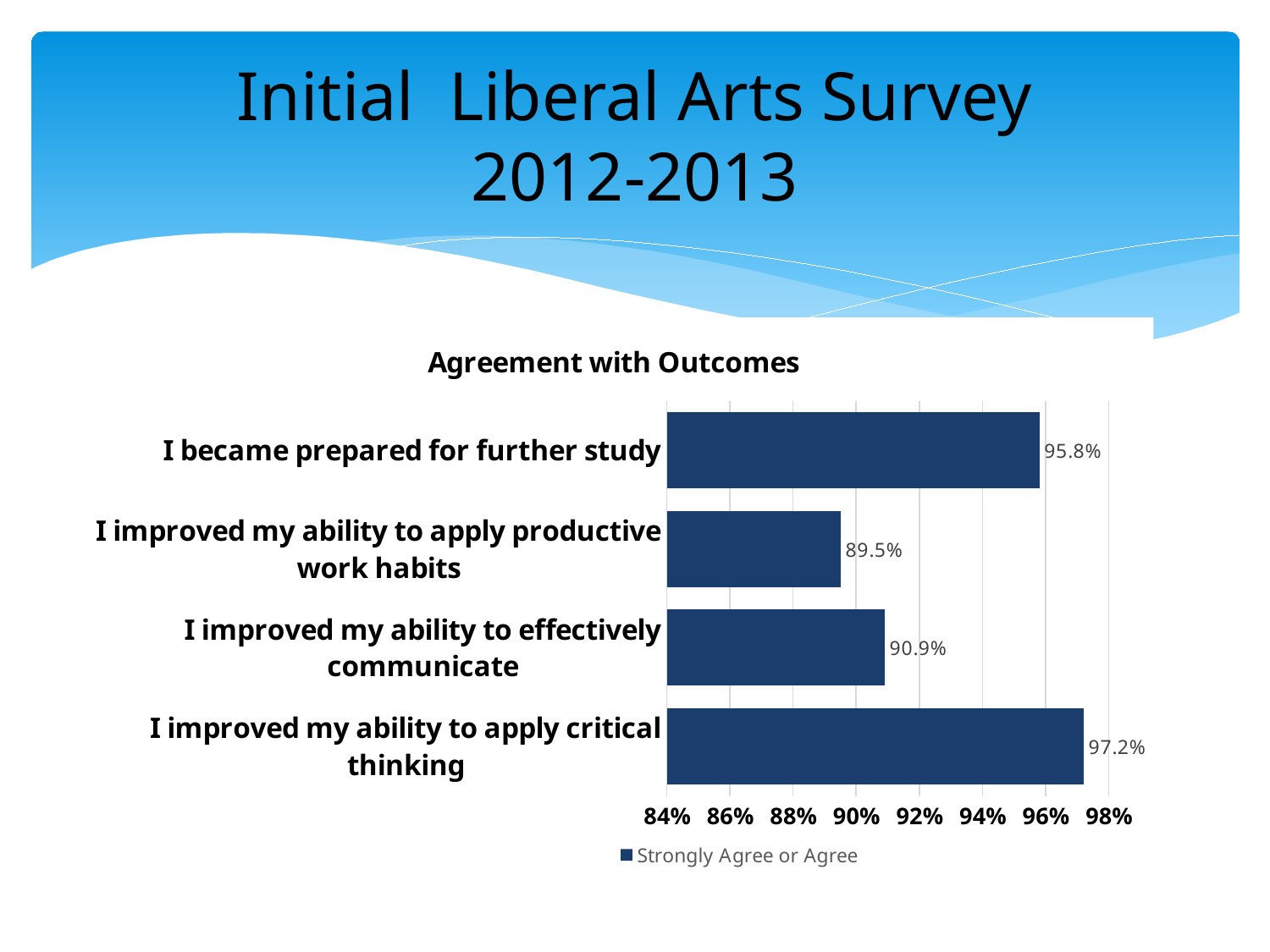
What is the title of the chart? Agreement with Outcomes How many outcome statements are shown in the chart? 4 Which outcome has the highest level of agreement? I improved my ability to apply critical thinking Is the value for "I improved my ability to effectively communicate" greater or less than 92%? less What is the value for "I improved my ability to apply critical thinking"? 97.2% What is the value for "I improved my ability to apply productive work habits"? 89.5% Which has a higher agreement value: "I became prepared for further study" or "I improved my ability to effectively communicate"? I became prepared for further study What percentage of respondents strongly agreed or agreed with "I became prepared for further study"? 95.8% What type of chart is shown on the slide? Bar chart What is the value for "I improved my ability to effectively communicate"? 90.9% Which outcome has the lowest level of agreement? I improved my ability to apply productive work habits What is the difference between the agreement for critical thinking and for productive work habits? 7.7%